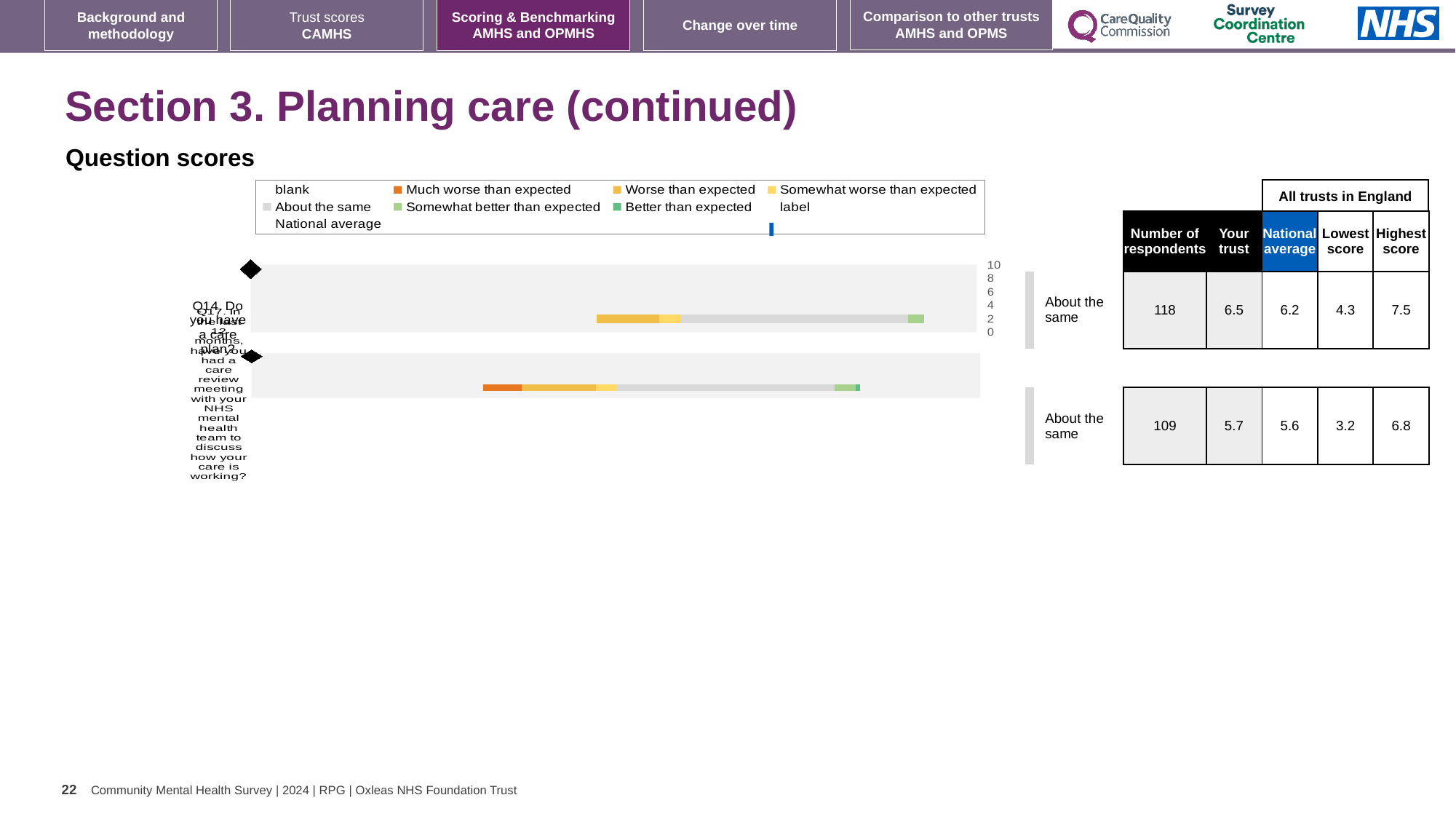
What is the highest score across all trusts in England for Q17? 6.8 How many respondents answered Q17? 109 What kind of chart is used to show the question scores on this slide? bar chart What is the 'Your trust' score for Q17 (care review meeting)? 5.7 How many questions (bars) are plotted in the question scores chart? 2 For Q14, which is higher: the 'Your trust' score or the national average? Your trust In the chart legend, what colour represents 'Much worse than expected'? orange What is the difference between the highest score and the lowest score for Q14 across all trusts in England? 3.2 Which question has the larger number of respondents, Q14 or Q17? Q14 What is the national average score for Q14? 6.2 In the chart legend, what colour represents 'Better than expected'? green What is the 'Your trust' score for Q14 (Do you have a care plan?)? 6.5